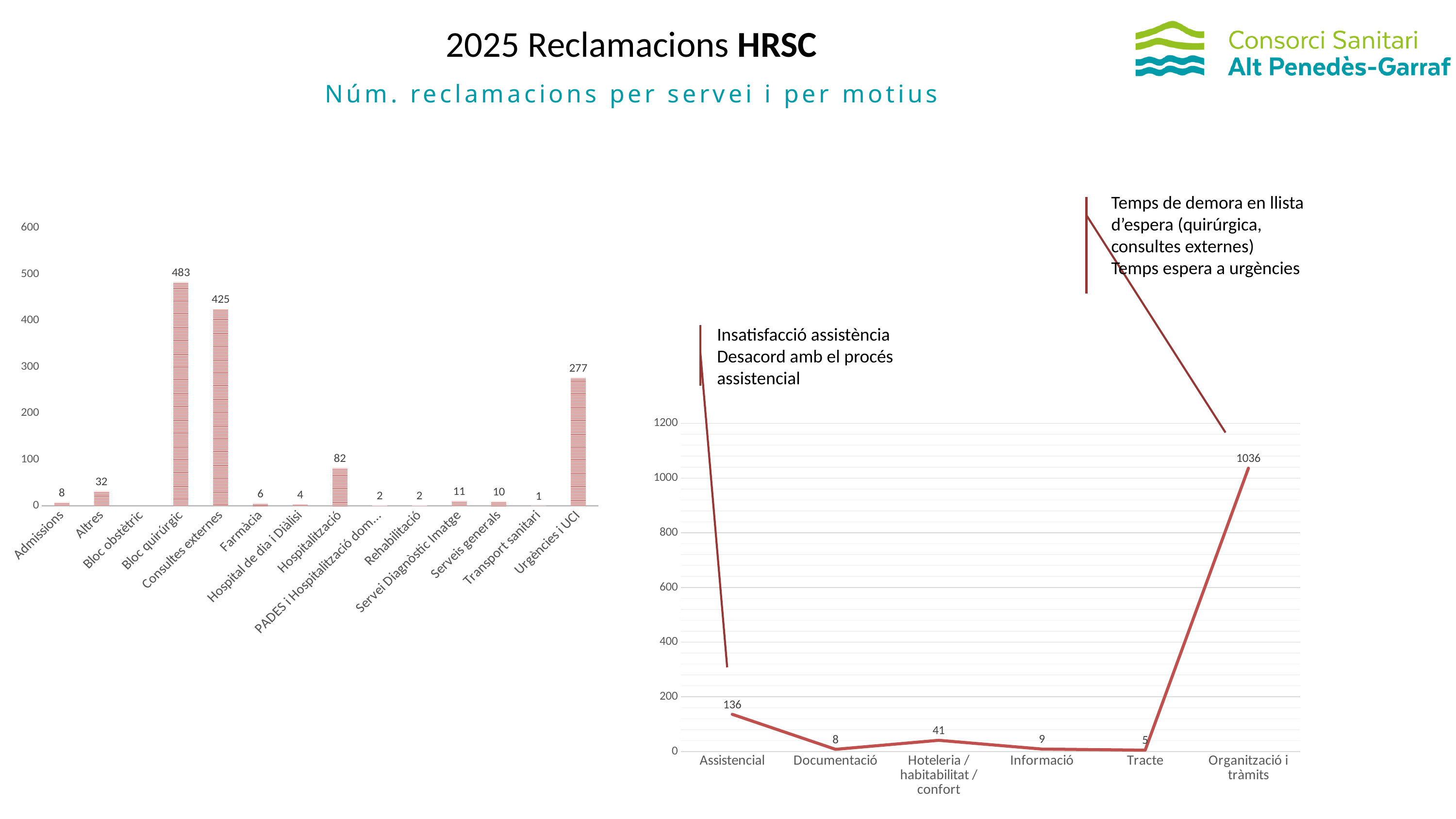
In the bar chart on the left, what is the value for Transport sanitari? 1 In the bar chart on the left, which category has the highest value? Bloc quirúrgic In the line chart on the right, what is the difference between Hoteleria / habitabilitat / confort and Documentació? 33 In the bar chart on the left, what is the value for Bloc quirúrgic? 483 In the line chart on the right, which category has the lowest value? Tracte In the bar chart on the left, what is the value for Urgències i UCI? 277 In the line chart on the right, what is the value for Assistencial? 136 In the bar chart on the left, what is the difference between Bloc quirúrgic and Consultes externes? 58 How many categories are shown on the x axis of the line chart on the right? 6 In the bar chart on the left, which is larger, Hospitalització or Altres? Hospitalització What kind of chart is the chart on the right? Line chart In the line chart on the right, what is the value for Organització i tràmits? 1036